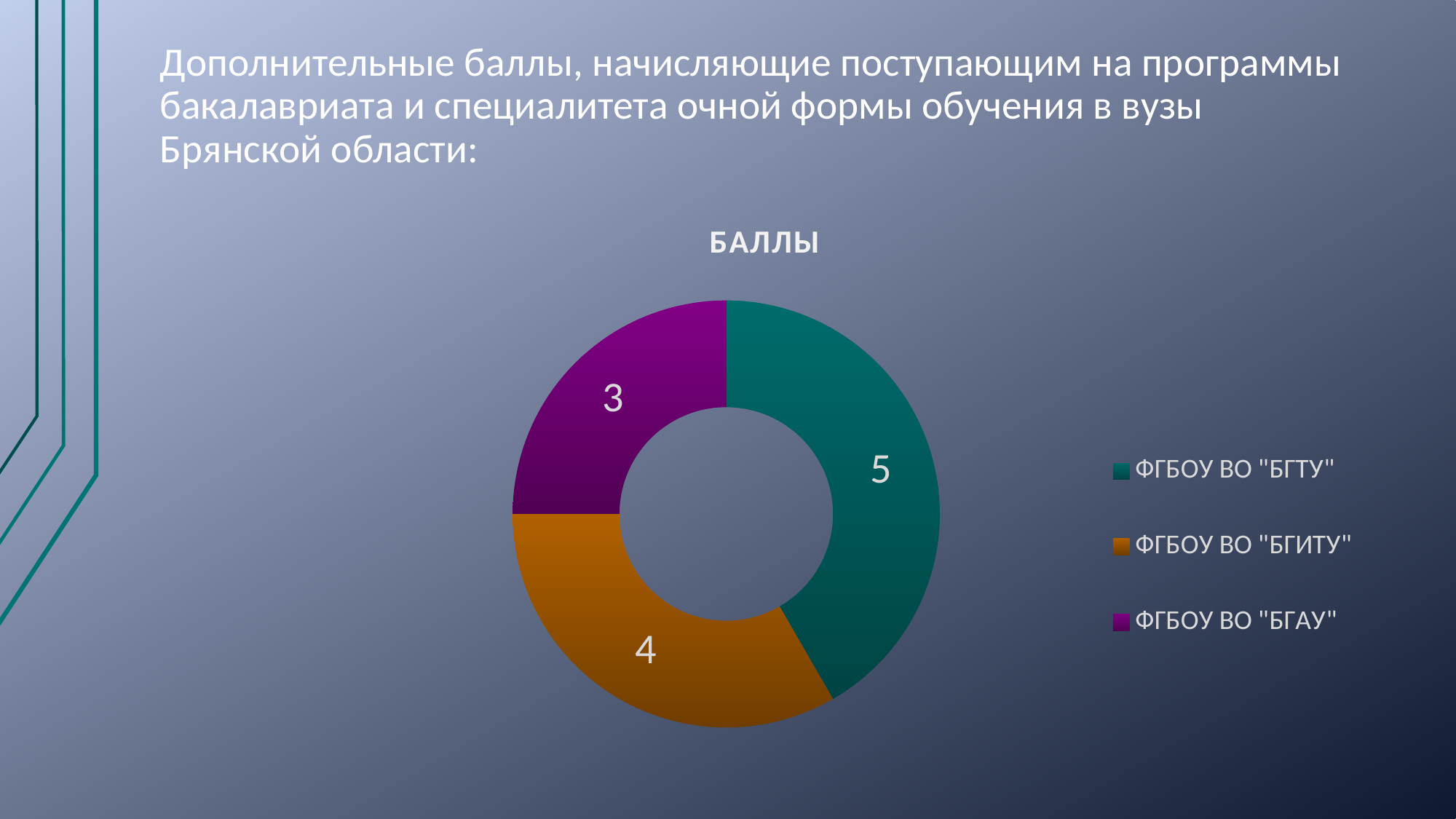
What kind of chart is shown on the slide? Doughnut (pie) chart What colour represents ФГБОУ ВО "БГАУ" in the chart? Purple What is the title of the chart? БАЛЛЫ What value is shown for ФГБОУ ВО "БГАУ"? 3 Which university has the highest value in the chart? ФГБОУ ВО "БГТУ" What value is shown for ФГБОУ ВО "БГИТУ"? 4 What is the total of all values shown in the chart? 12 Which is larger, the value for ФГБОУ ВО "БГИТУ" or for ФГБОУ ВО "БГАУ"? ФГБОУ ВО "БГИТУ" What is the difference between the values for ФГБОУ ВО "БГТУ" and ФГБОУ ВО "БГАУ"? 2 How many categories are shown in the chart? 3 Which university has the lowest value in the chart? ФГБОУ ВО "БГАУ" What value is shown for ФГБОУ ВО "БГТУ"? 5